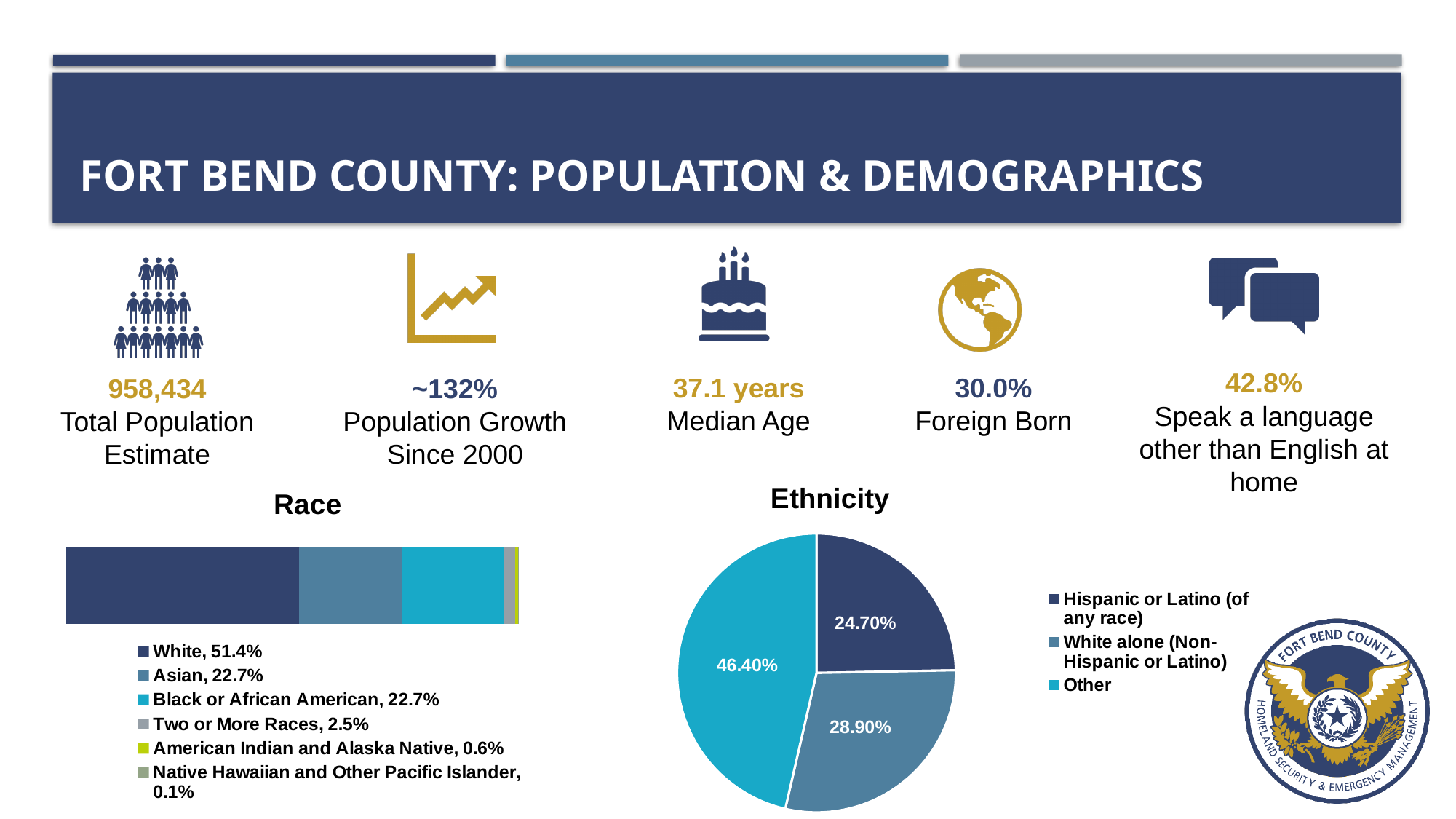
In the Ethnicity chart, which slice is the largest? Other What kind of chart is the Race chart? Stacked bar chart In the Ethnicity chart, what is the difference between the Other slice and the White alone (Non-Hispanic or Latino) slice? 17.50% How many race categories does the legend of the Race chart list? 6 In the Race chart, what percentage is shown for White? 51.4% In the Race chart, what is the difference between the White share and the Asian share? 28.7% How many slices does the Ethnicity pie chart have? 3 In the Race chart, what percentage is shown for Two or More Races? 2.5% In the Race chart, which race category has the largest share? White In the Race chart, which race category has the smallest share? Native Hawaiian and Other Pacific Islander In the Ethnicity chart, what percentage is shown for Hispanic or Latino (of any race)? 24.70% In the Ethnicity chart, which is larger: White alone (Non-Hispanic or Latino) or Hispanic or Latino (of any race)? White alone (Non-Hispanic or Latino)